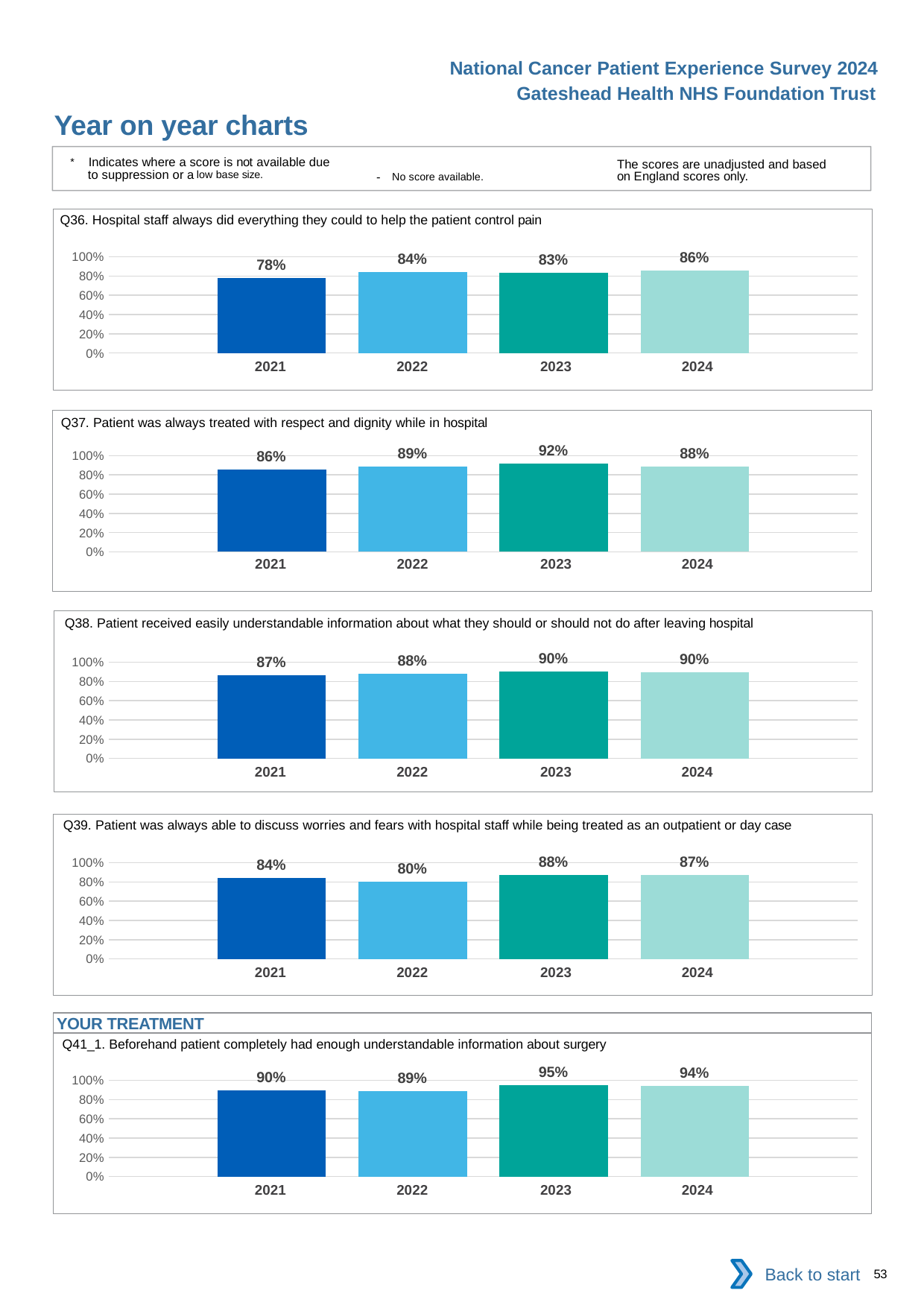
In the Q39 chart (discuss worries and fears as an outpatient), what is the value for 2022? 80% In the Q36 chart (hospital staff helped control pain), what is the value for 2021? 78% In the Q37 chart (treated with respect and dignity), what is the value for 2023? 92% How many years are plotted in the Q36 chart (hospital staff helped control pain)? 4 In the Q38 chart (understandable information after leaving hospital), which year has the lowest value? 2021 In the Q41_1 chart (information about surgery), what is the value for 2023? 95% In the Q37 chart (treated with respect and dignity), what is the difference between the 2023 and 2024 values? 4 percentage points What kind of chart is used for Q37 (treated with respect and dignity)? bar chart In the Q36 chart (hospital staff helped control pain), which year has the highest value? 2024 In the Q41_1 chart (information about surgery), what is the difference between the 2021 and 2022 values? 1 percentage point In the Q39 chart (discuss worries and fears as an outpatient), which is larger, the 2021 value or the 2024 value? 2024 In the Q38 chart (understandable information after leaving hospital), do the values rise or fall from 2021 to 2023? rise